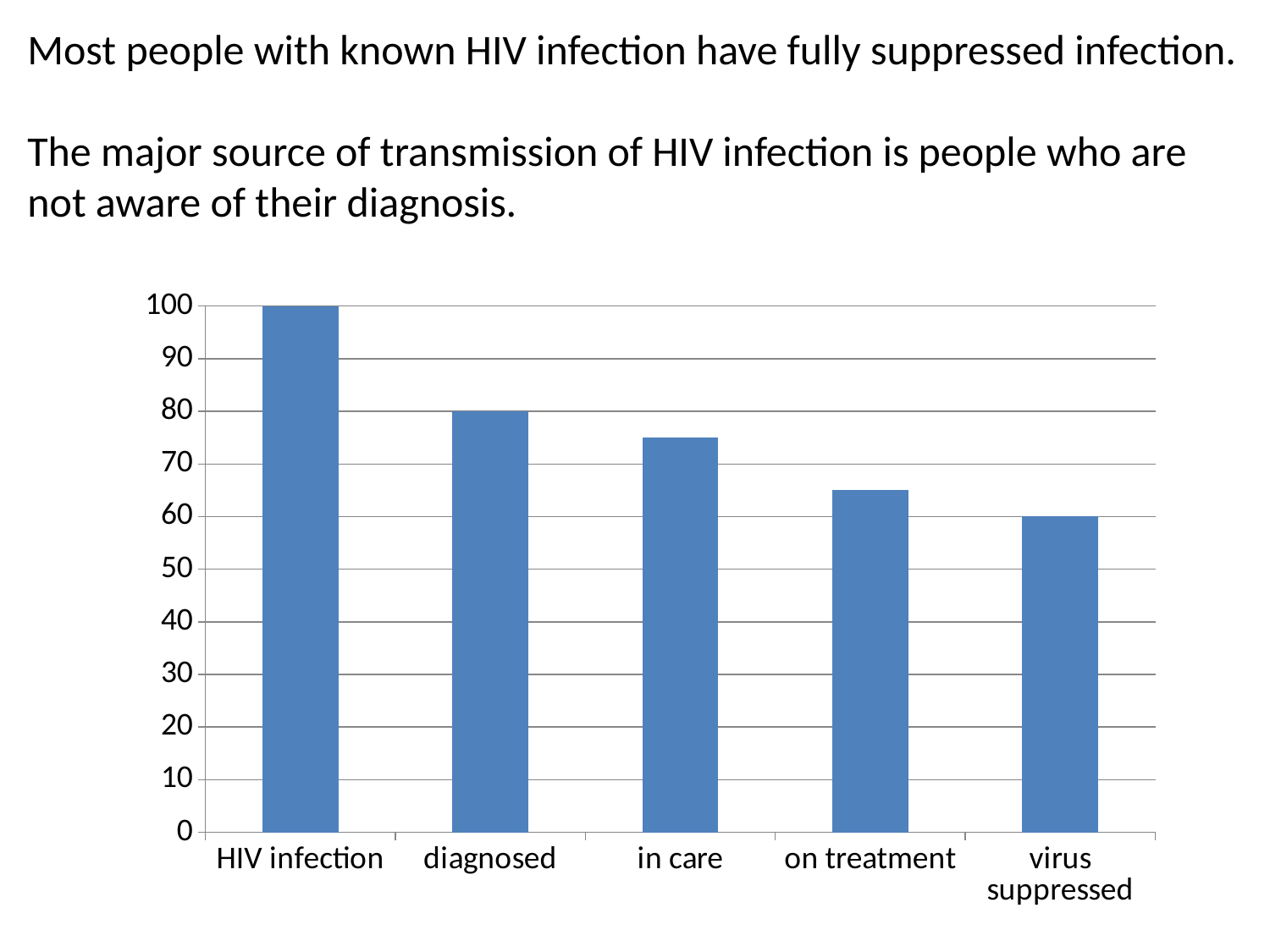
How many categories are shown on the x axis of the chart? 5 What is the difference between the values for HIV infection and diagnosed? 20 What is the value for virus suppressed? 60 Which category has the lowest value? virus suppressed What type of chart is shown on the slide? bar chart Do the values rise or fall from left to right along the x axis? fall What is the value for diagnosed? 80 Is the value for in care greater or less than 70? greater Which category has the highest value? HIV infection What is the value for HIV infection? 100 Is the value for on treatment greater or less than 70? less Which is larger, the value for in care or the value for on treatment? in care